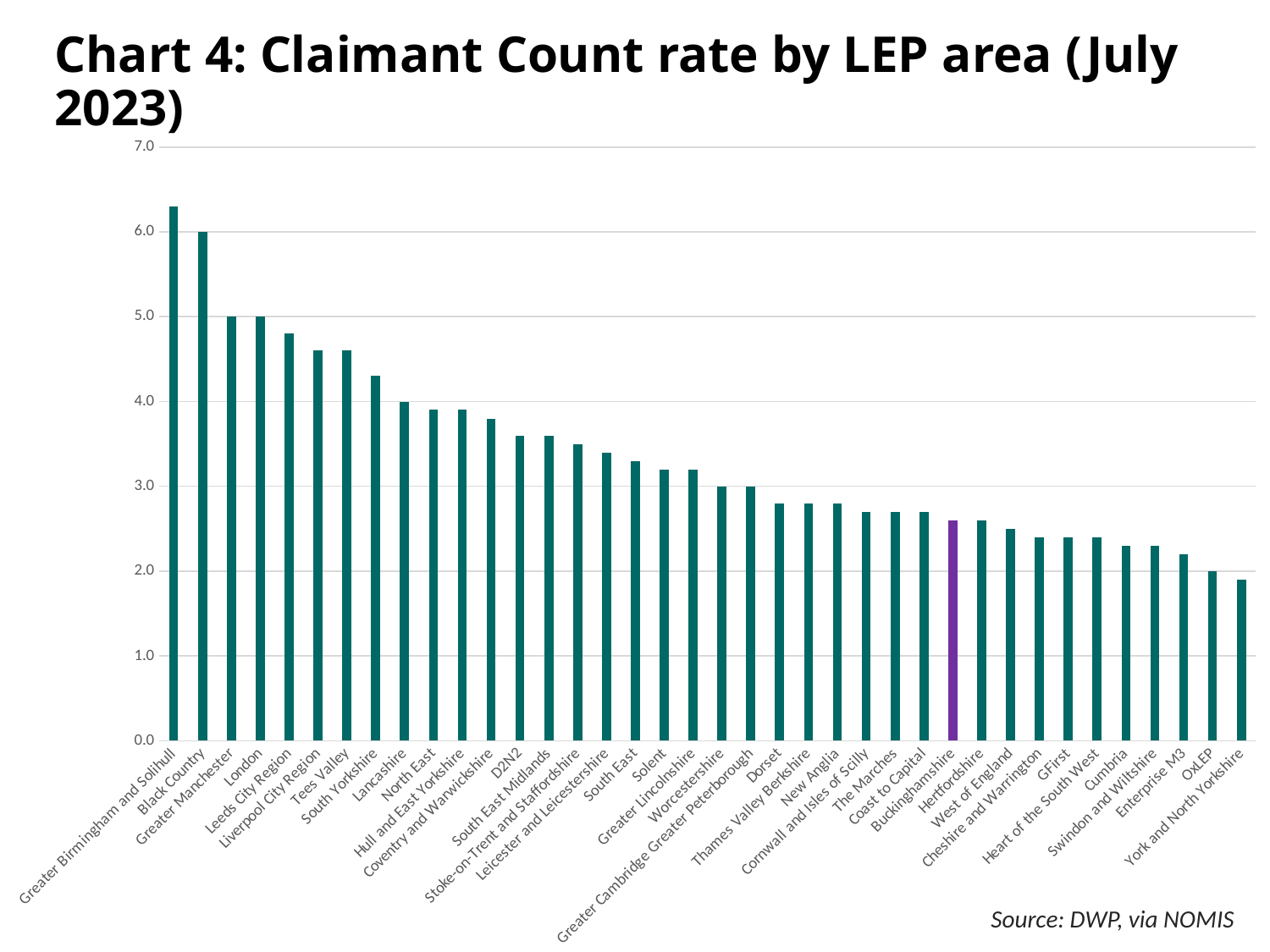
Is the value for Greater Birmingham and Solihull greater or less than 6.0? greater Is the value for Buckinghamshire greater or less than 2.0? greater Which has a higher Claimant Count rate, Black Country or Tees Valley? Black Country Which LEP area has the lowest Claimant Count rate? York and North Yorkshire Which LEP area's bar is highlighted in purple? Buckinghamshire Is the value for Leeds City Region greater or less than 5.0? less What is the source cited for the chart? DWP, via NOMIS What kind of chart is shown on the slide? bar chart Which LEP area has the highest Claimant Count rate? Greater Birmingham and Solihull Do the values rise or fall moving from left to right along the x axis? fall